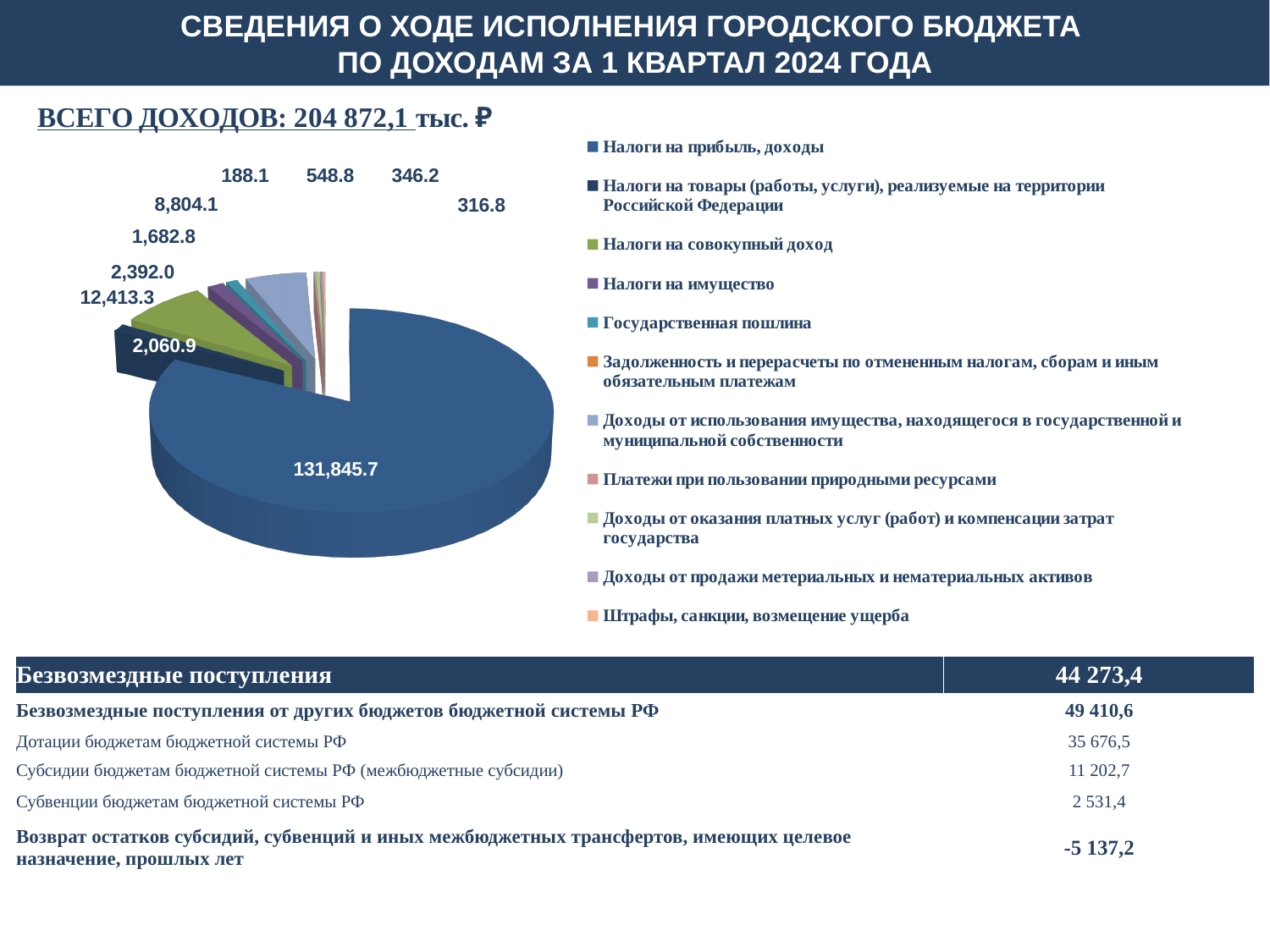
Which category has the largest slice in the pie chart? Налоги на прибыль, доходы Which is larger in the pie chart: Налоги на совокупный доход or Доходы от использования имущества, находящегося в государственной и муниципальной собственности? Налоги на совокупный доход What is the difference between the value for Налоги на прибыль, доходы and the value for Налоги на совокупный доход in the pie chart? 119,432.4 What kind of chart is shown on the slide? pie chart What total income (ВСЕГО ДОХОДОВ) is stated above the pie chart? 204 872,1 тыс. ₽ What is the value of the largest slice in the pie chart? 131,845.7 What colour is the largest slice of the pie chart? dark blue What is the value shown for Налоги на совокупный доход in the pie chart? 12,413.3 What is the value shown for Доходы от использования имущества, находящегося в государственной и муниципальной собственности in the pie chart? 8,804.1 How many categories does the legend of the pie chart list? 11 Which category is the second-largest slice in the pie chart? Налоги на совокупный доход